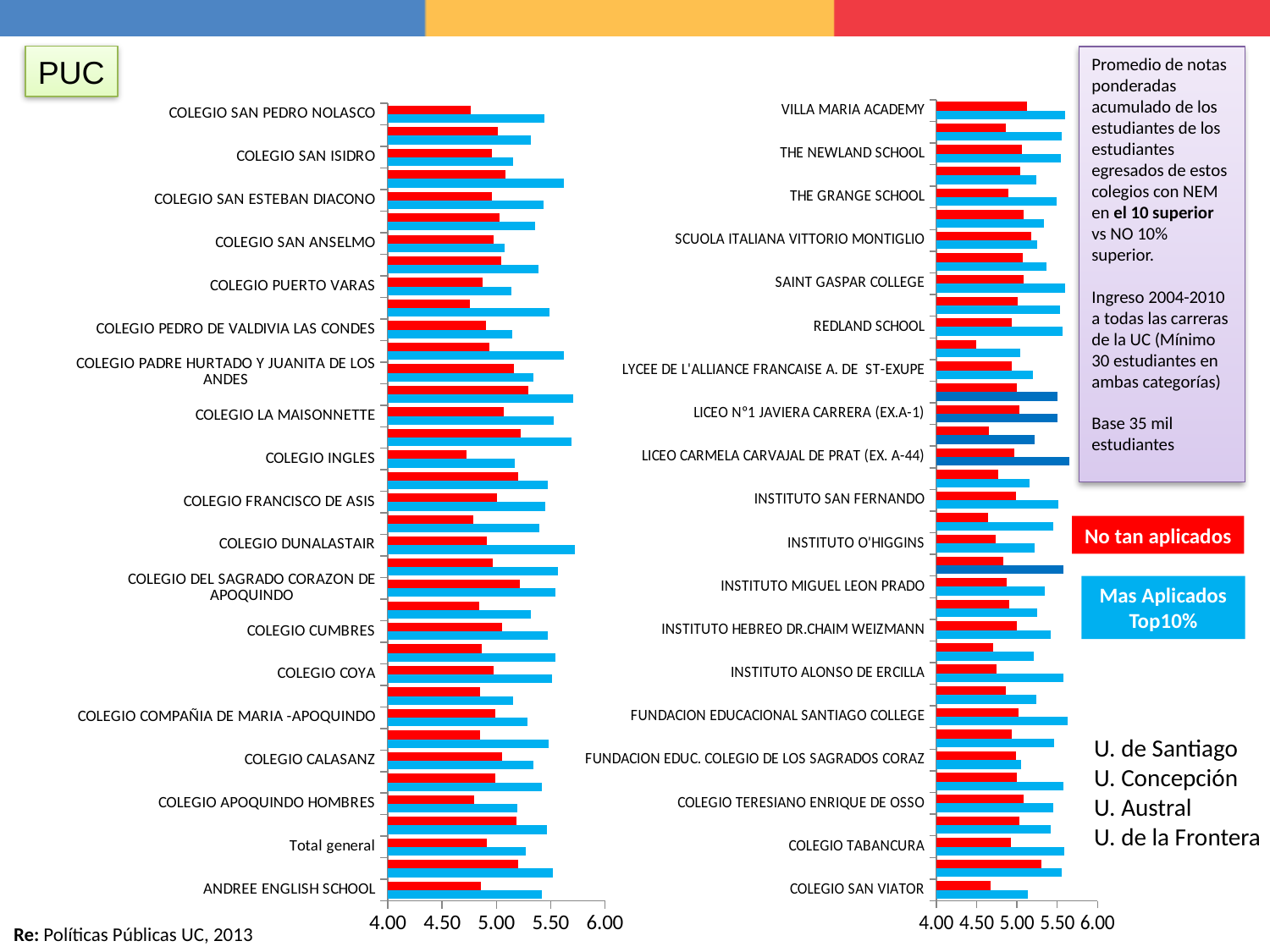
In the left chart, is the blue (Mas Aplicados Top10%) value for COLEGIO DUNALASTAIR greater or less than 5.50? greater What kind of chart is the left chart on the slide? bar chart Which series is shown in red in the charts? No tan aplicados In the left chart, for COLEGIO SAN PEDRO NOLASCO, which series has the larger value: the red (No tan aplicados) or the blue (Mas Aplicados Top10%)? Mas Aplicados Top10% What kind of chart is the right chart on the slide? bar chart In the right chart, is the blue (Mas Aplicados Top10%) value for VILLA MARIA ACADEMY greater or less than 5.00? greater In the left chart, is the red (No tan aplicados) value for COLEGIO INGLES greater or less than 5.00? less How many series are shown in the charts, according to the legend boxes on the right? 2 Which series is shown in blue in the charts? Mas Aplicados Top10%